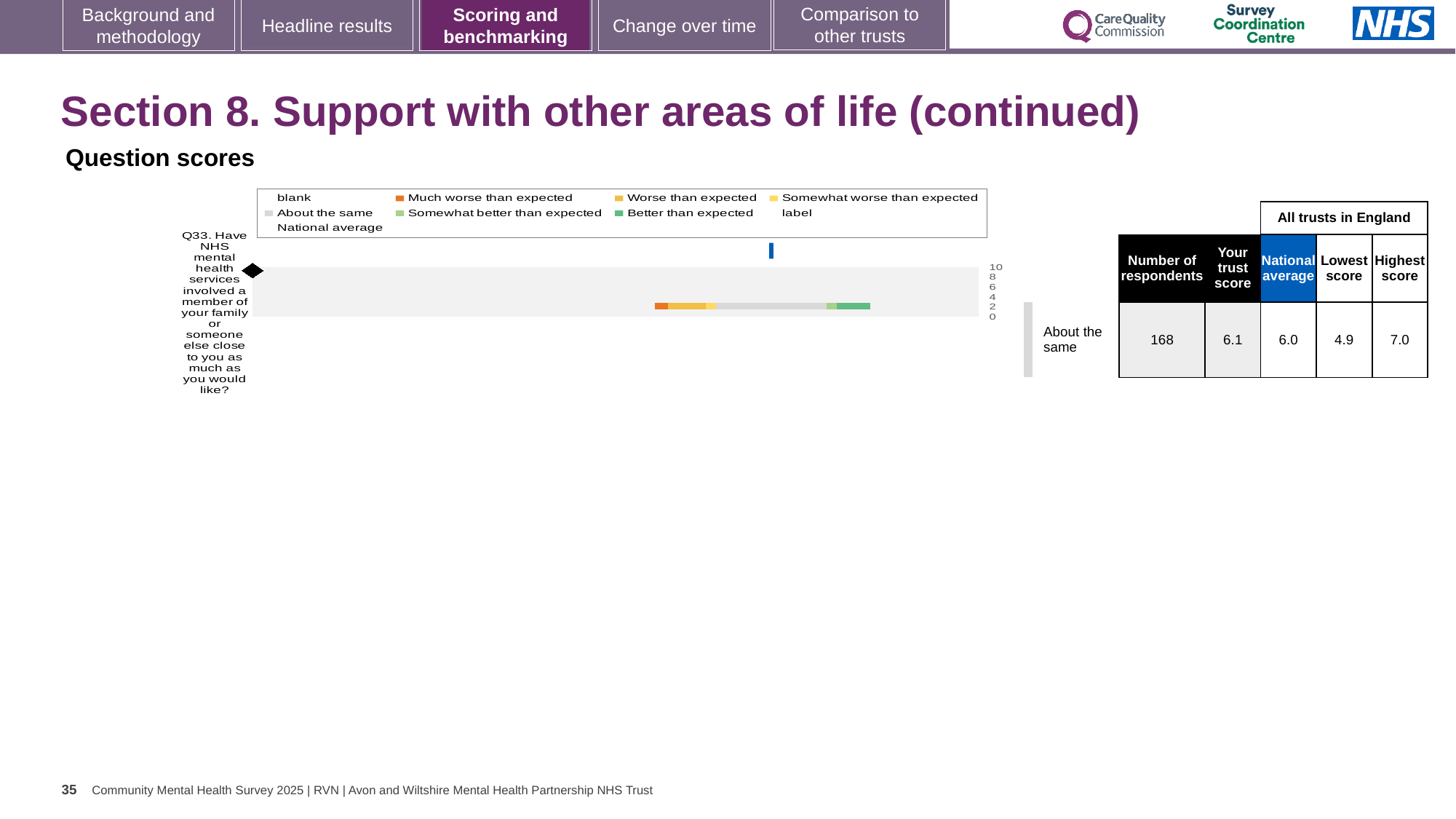
Which is larger for Q33: the trust's score or the national average? the trust's score What is the trust's score for Q33 (involving a family member or someone close as much as you would like)? 6.1 Is the trust's score for Q33 greater or less than 5 on the axis? greater What is the national average score for Q33? 6.0 What benchmark category is the trust's Q33 score placed in? About the same How many survey questions are plotted on the chart? 1 What kind of chart is shown on the slide? bar chart What is the difference between the highest and lowest scores for Q33 across all trusts in England? 2.1 By how much does the trust's score for Q33 exceed the national average? 0.1 What is the highest score among all trusts in England for Q33? 7.0 What is the lowest score among all trusts in England for Q33? 4.9 How many respondents answered Q33? 168